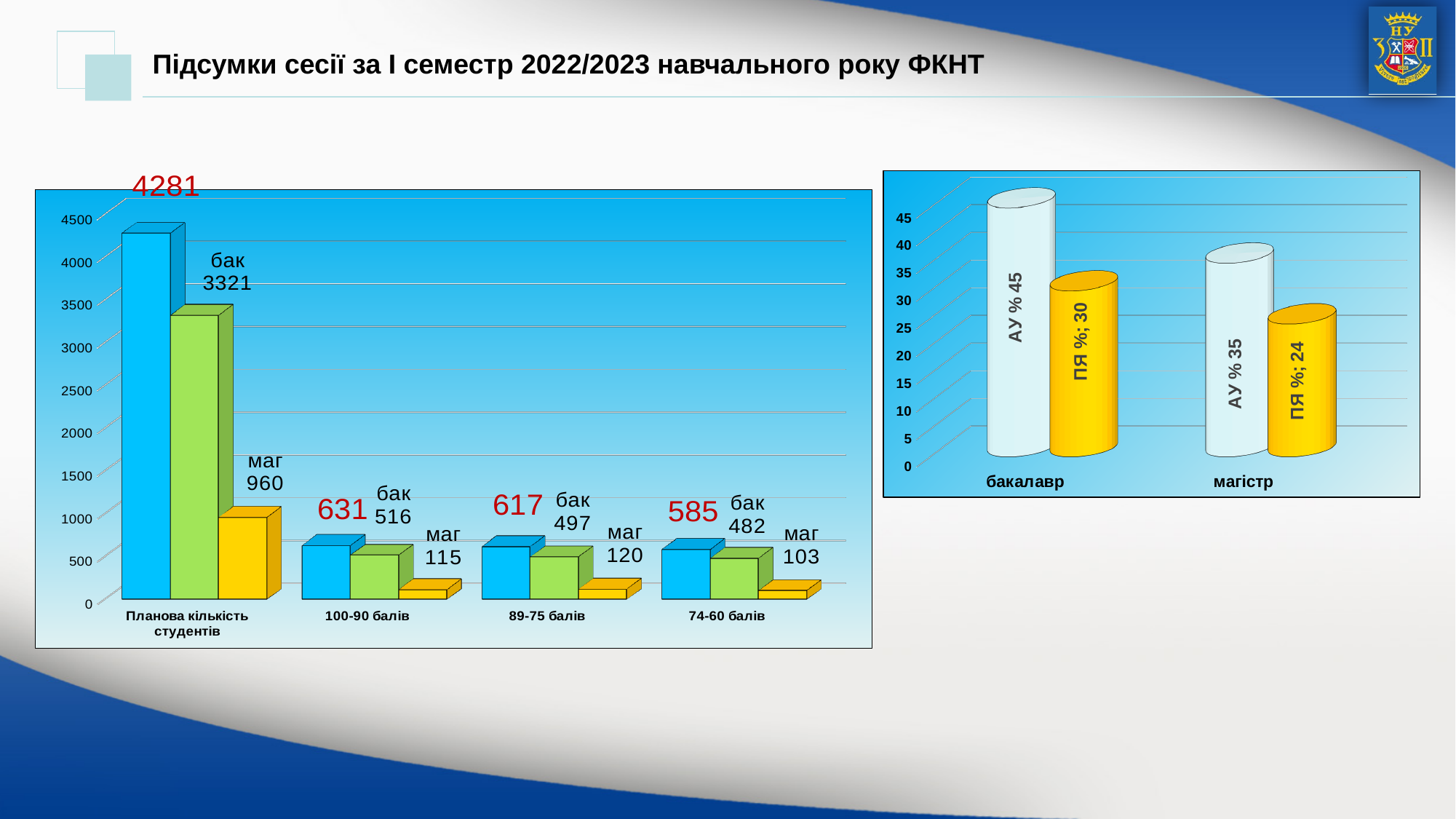
In the left chart, which is larger: the 'маг' value for '100-90 балів' or the 'маг' value for '89-75 балів'? 89-75 балів In the left chart, what is the total value shown for 'Планова кількість студентів'? 4281 In the left chart, what is the 'бак' value for '100-90 балів'? 516 In the left chart, what is the 'маг' value for '74-60 балів'? 103 How many categories are shown on the x axis of the left chart? 4 In the left chart, what is the 'маг' value for '89-75 балів'? 120 In the left chart, what is the difference between the 'бак' value for 'Планова кількість студентів' and the 'маг' value for the same category? 2361 What kind of chart is the left chart? bar chart In the right chart, what is the difference between the 'АУ %' values for 'бакалавр' and 'магістр'? 10 In the right chart, what is the 'АУ %' value for 'бакалавр'? 45 In the left chart, which category has the lowest total (blue bar) value? 74-60 балів In the right chart, what is the 'ПЯ %' value for 'магістр'? 24